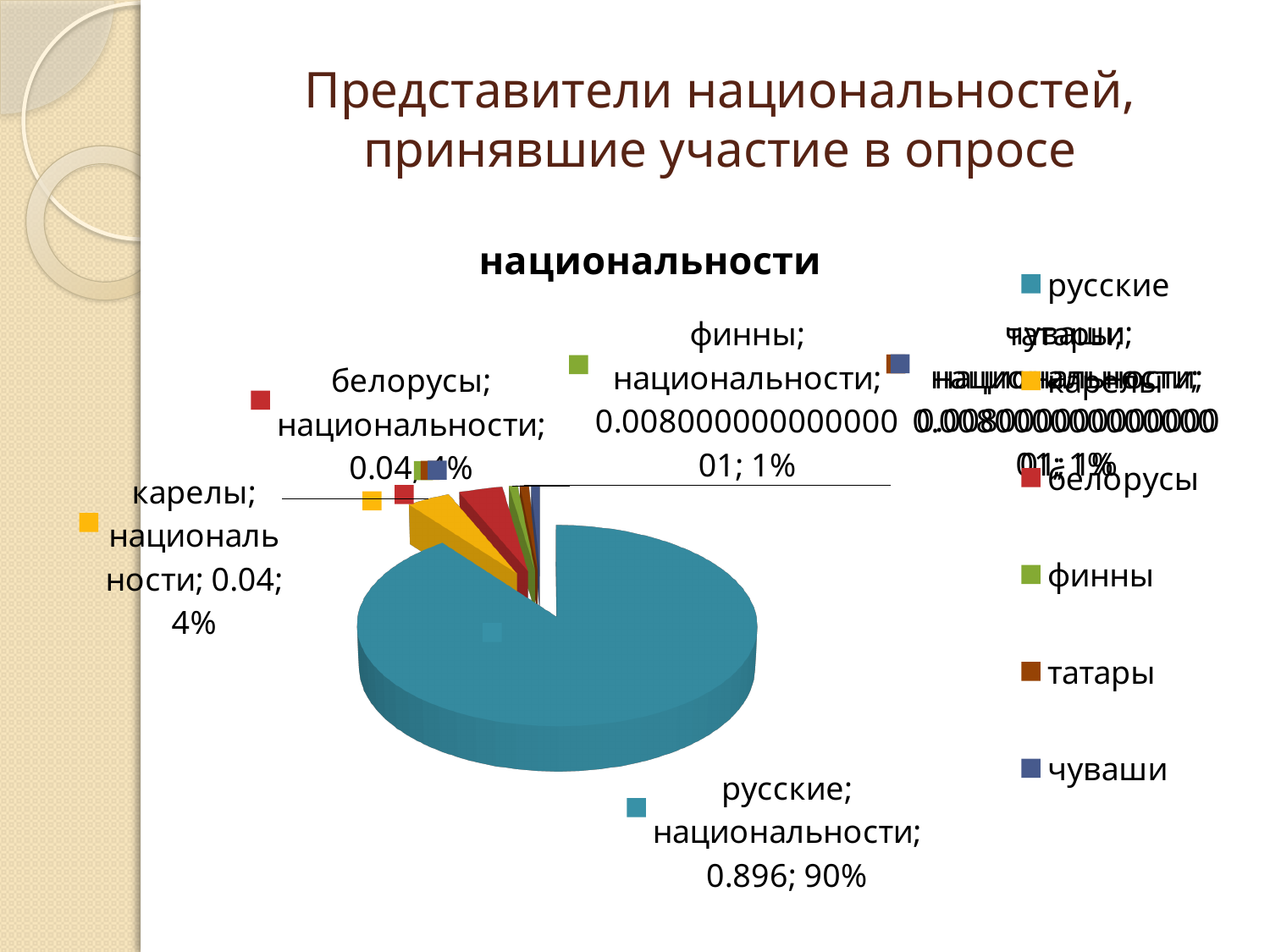
How many categories (slices) does the pie chart have? 6 What kind of chart is shown on the slide? pie chart Which nationality has the largest share of the pie? русские What value is printed for русские in the data label? 0.896 What is the title of the chart? национальности How many entries does the chart legend list? 6 What percentage share is shown for белорусы? 4% What percentage share is shown for финны? 1% What percentage share is shown for русские? 90% Which is larger, the share for русские or the share for карелы? русские What is the difference in percentage points between the share for русские and the share for белорусы? 86%